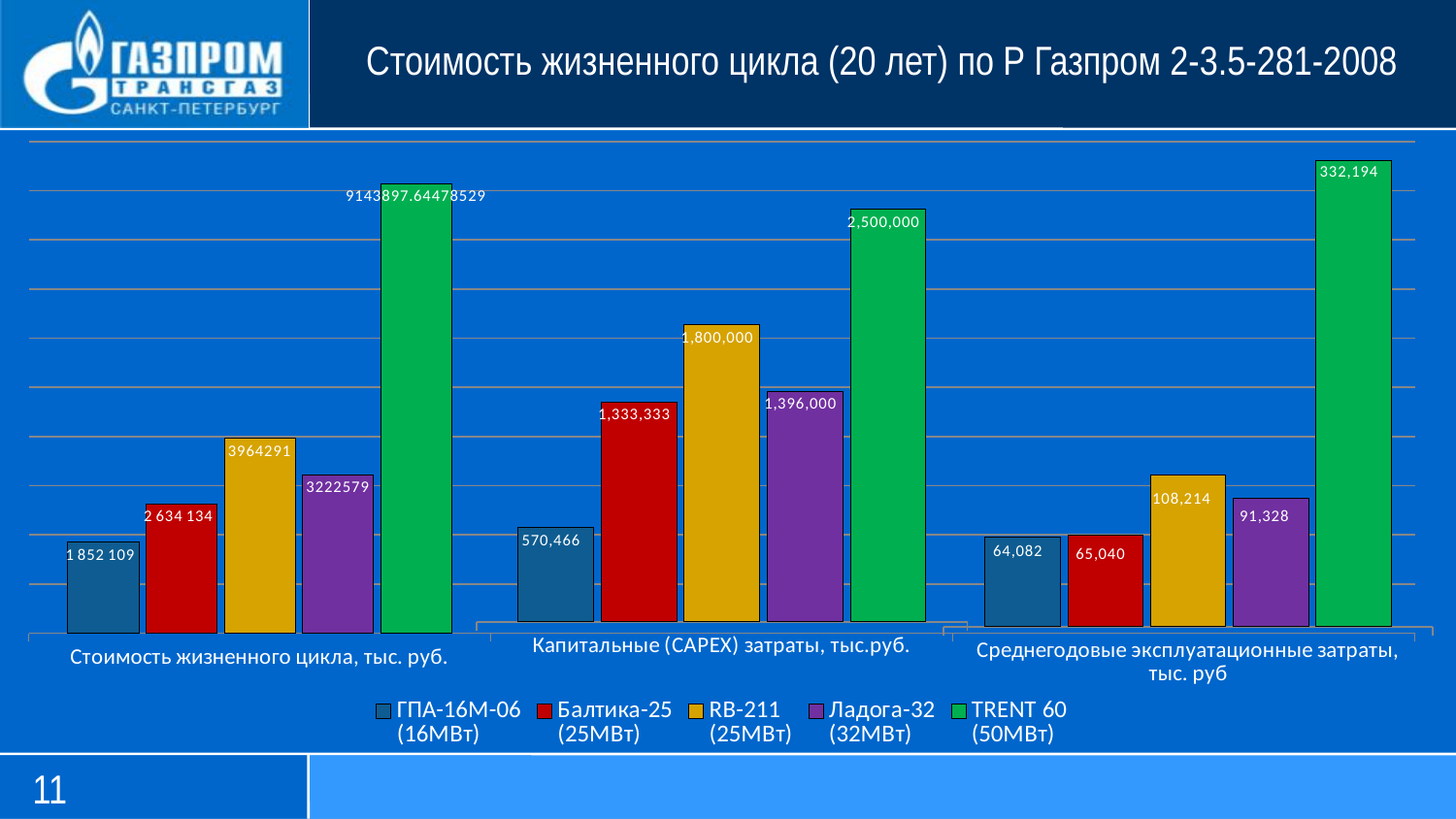
What is the value for Ладога-32 (32МВт) in the category 'Среднегодовые эксплуатационные затраты, тыс. руб'? 91,328 How many series does the legend list? 5 Which series has the highest value in the category 'Среднегодовые эксплуатационные затраты, тыс. руб'? TRENT 60 (50МВт) In the category 'Капитальные (CAPEX) затраты, тыс.руб.', which is larger: the value for RB-211 (25МВт) or for Ладога-32 (32МВт)? RB-211 (25МВт) What type of chart is shown on the slide? bar chart In the category 'Капитальные (CAPEX) затраты, тыс.руб.', what is the difference between the values for TRENT 60 (50МВт) and RB-211 (25МВт)? 700,000 In the category 'Стоимость жизненного цикла, тыс. руб.', what is the difference between the values for Балтика-25 (25МВт) and ГПА-16М-06 (16МВт)? 782 025 Which series has the lowest value in the category 'Капитальные (CAPEX) затраты, тыс.руб.'? ГПА-16М-06 (16МВт) What is the value for TRENT 60 (50МВт) in the category 'Капитальные (CAPEX) затраты, тыс.руб.'? 2,500,000 What is the title of the chart? Стоимость жизненного цикла (20 лет) по Р Газпром 2-3.5-281-2008 How many categories are shown on the x axis? 3 What is the value for ГПА-16М-06 (16МВт) in the category 'Стоимость жизненного цикла, тыс. руб.'? 1 852 109